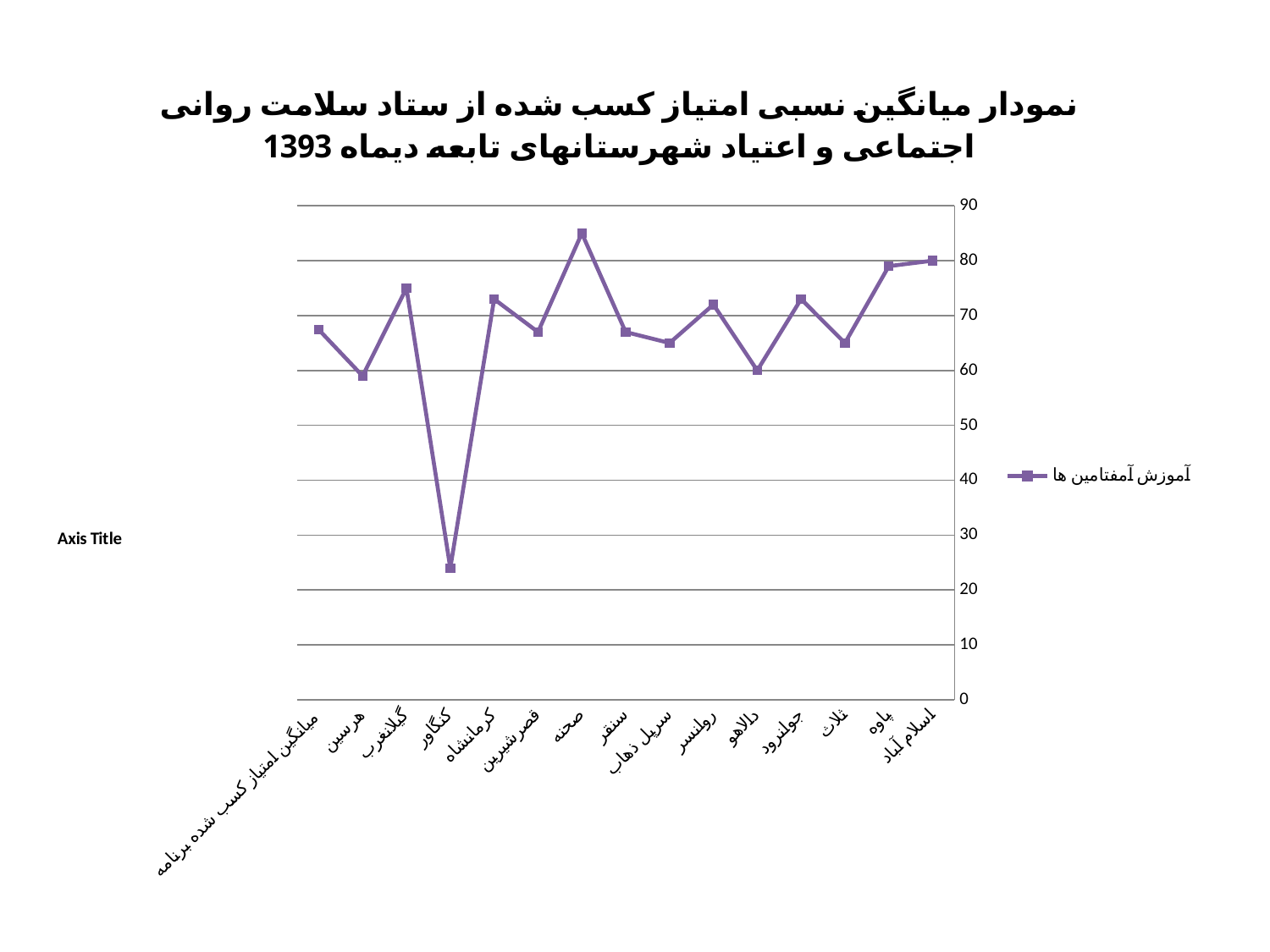
Is the value for گیلانغرب greater or less than 70? greater Which is larger, the value for اسلام آباد or the value for دالاهو? اسلام آباد What is the name of the series shown in the legend? آموزش آمفتامین ها Which category has the highest value? صحنه How many categories are plotted along the x axis? 15 What kind of chart is shown on the slide? line chart Is the value for صحنه greater or less than 80? greater Is the value for ثلاث greater or less than 70? less How many series does the legend list? 1 Which is larger, the value for گیلانغرب or the value for هرسین? گیلانغرب Which category has the lowest value? کنگاور